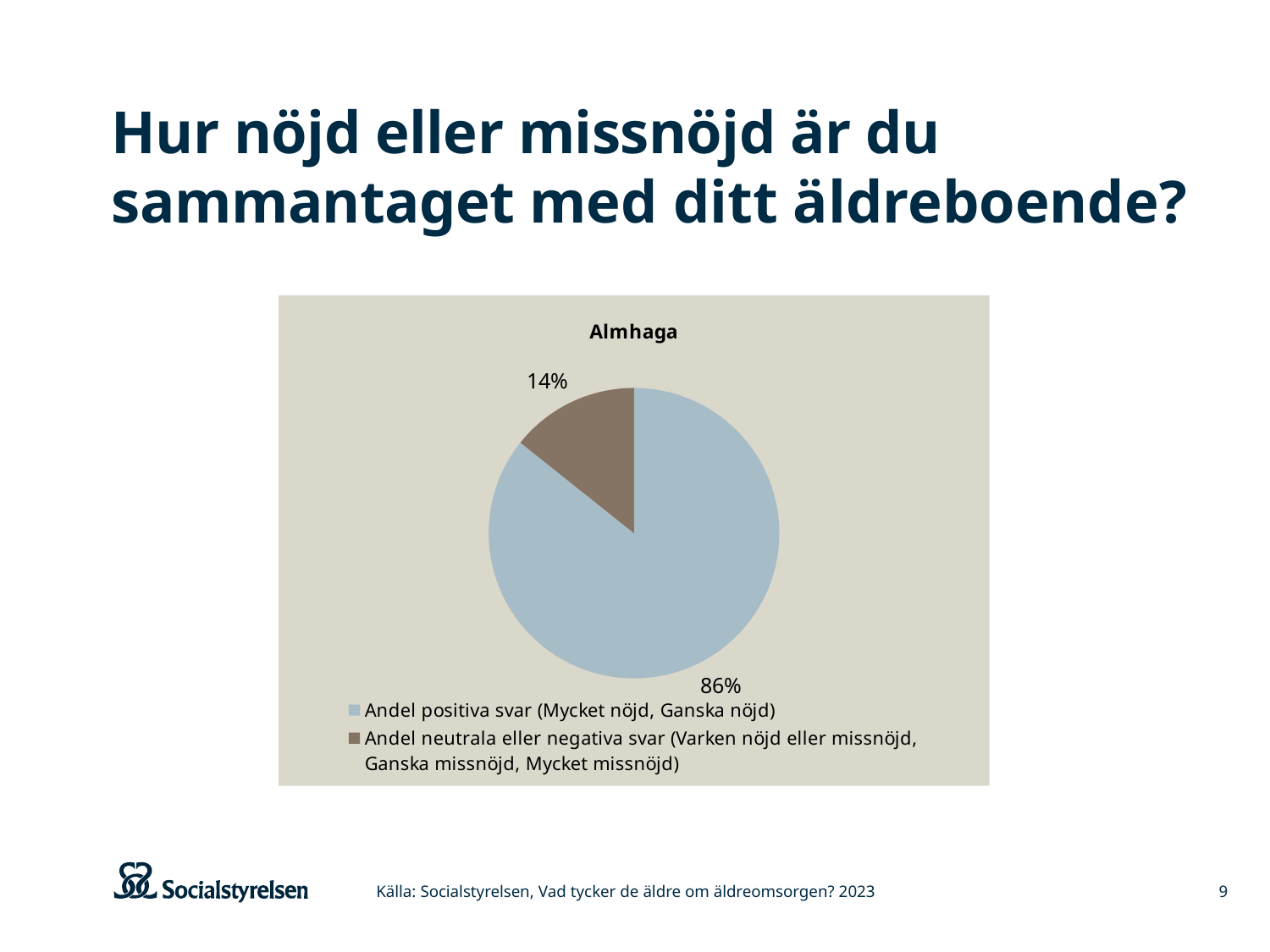
What is the difference in percentage points between the positive slice and the neutral/negative slice? 72 percentage points Which slice is the largest in the pie chart? Andel positiva svar (Mycket nöjd, Ganska nöjd) What colour is the slice for 'Andel positiva svar (Mycket nöjd, Ganska nöjd)'? light blue What share of the pie is 'Andel neutrala eller negativa svar (Varken nöjd eller missnöjd, Ganska missnöjd, Mycket missnöjd)'? 14% What is the title of the chart? Almhaga How many entries does the legend list? 2 What kind of chart is shown on the slide? pie chart How many slices does the pie chart have? 2 What share of the pie is 'Andel positiva svar (Mycket nöjd, Ganska nöjd)'? 86% Which is larger: the share of positive answers or the share of neutral or negative answers? Andel positiva svar (Mycket nöjd, Ganska nöjd) What is the total of the two slices shown in the pie chart? 100% Which slice is the smallest in the pie chart? Andel neutrala eller negativa svar (Varken nöjd eller missnöjd, Ganska missnöjd, Mycket missnöjd)